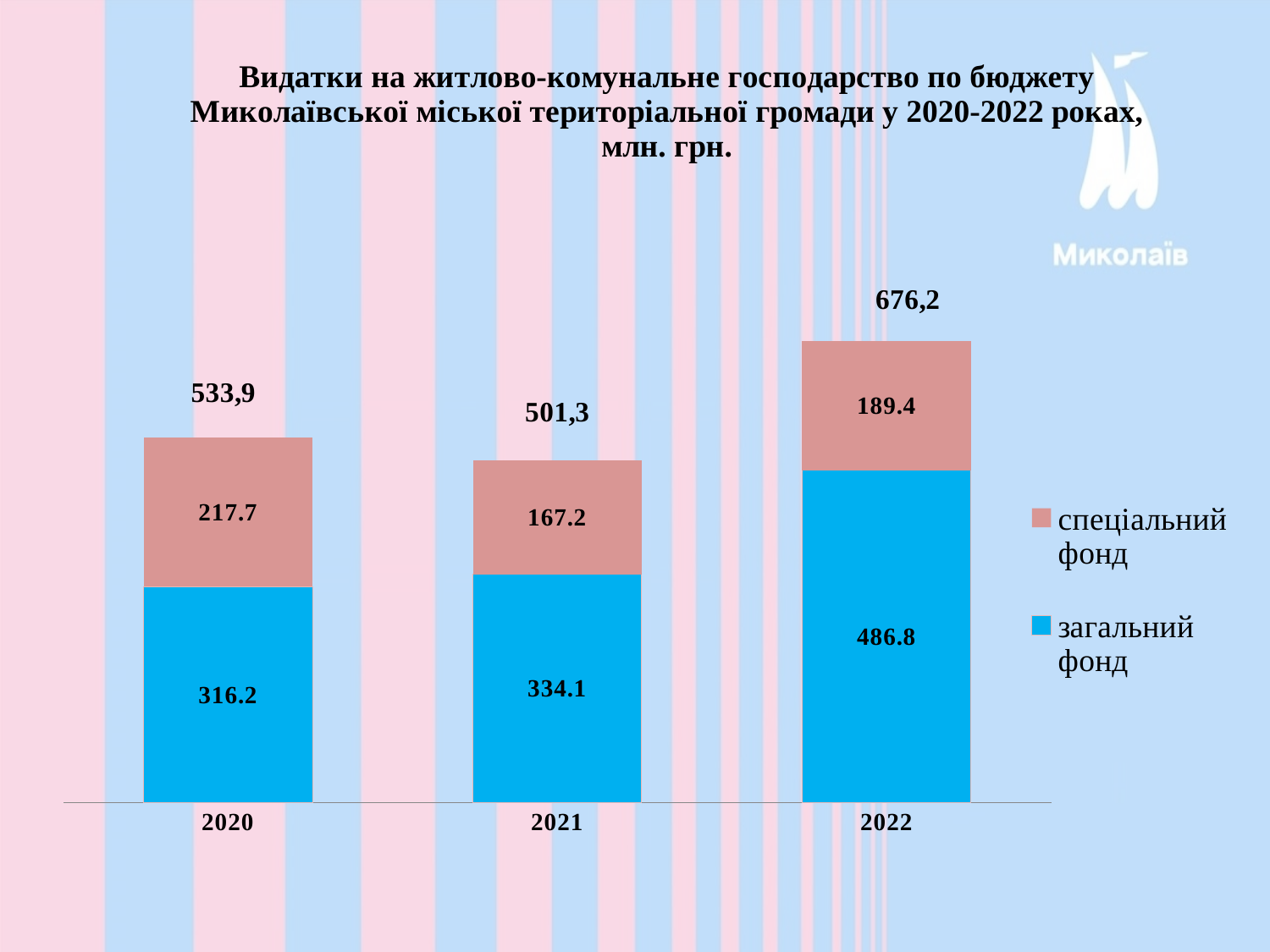
What is the total shown above the stacked bar for 2022? 676,2 What is the value of спеціальний фонд for 2021? 167.2 What kind of chart is shown on the slide? Stacked bar chart How many series does the legend list? 2 What is the difference between the загальний фонд values for 2022 and 2021? 152.7 Which year has the highest value for загальний фонд? 2022 What is the total shown above the stacked bar for 2021? 501,3 Which year has the lowest value for спеціальний фонд? 2021 How many years are shown on the x axis? 3 What is the value of спеціальний фонд for 2020? 217.7 What is the value of загальний фонд for 2022? 486.8 Which is larger: спеціальний фонд in 2020 or спеціальний фонд in 2022? спеціальний фонд in 2020